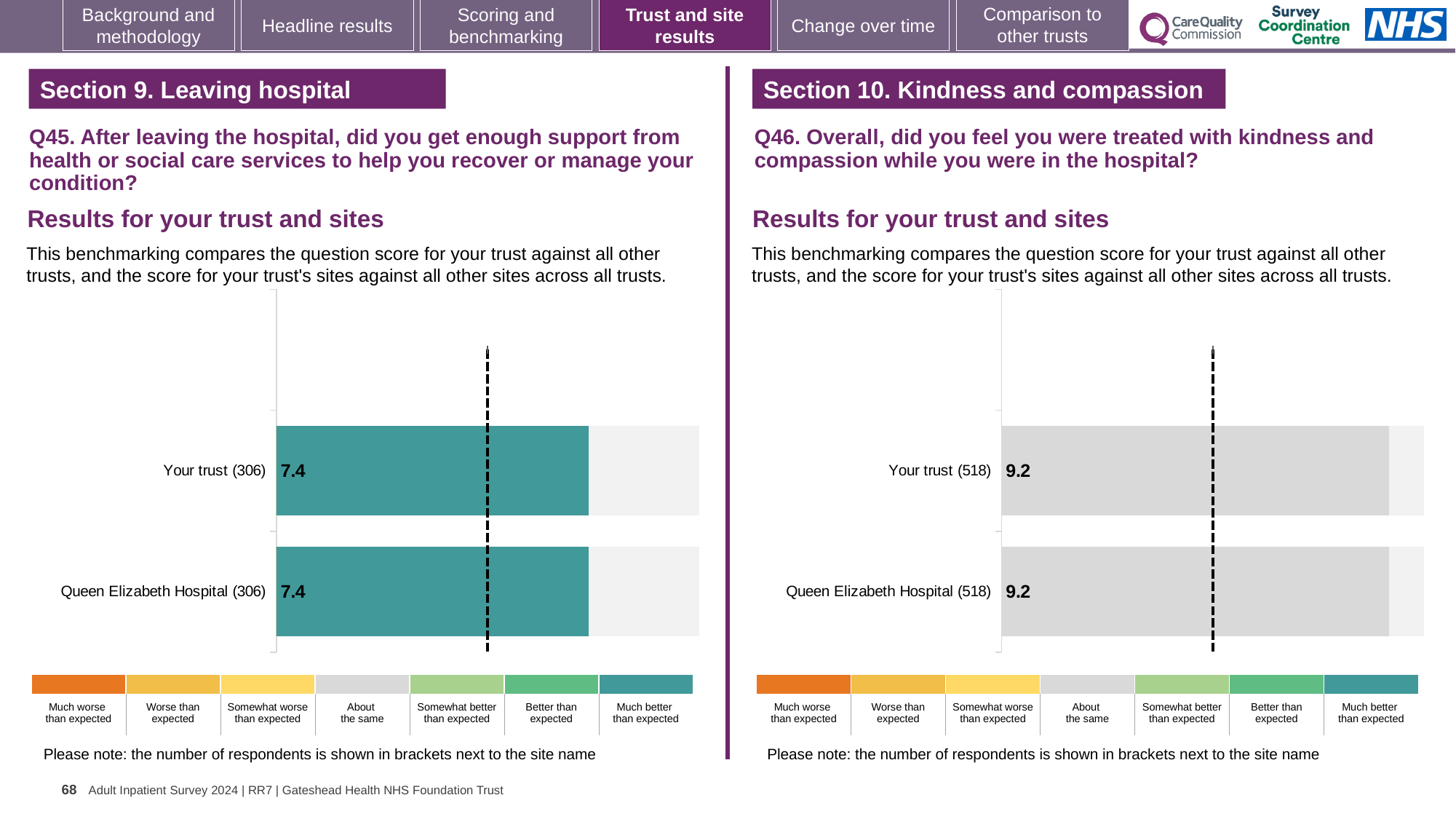
According to the colour key, which benchmark category do the bars on the Q46 chart (right) fall into? About the same On the Q46 chart (right), what is the difference between the score for Your trust and the score for Queen Elizabeth Hospital? 0.0 On the Q45 chart (left), what is the difference between the score for Your trust and the score for Queen Elizabeth Hospital? 0.0 On the Q45 chart (left), what is the score for Your trust? 7.4 On the Q46 chart (right), what is the score for Your trust? 9.2 On the Q46 chart (right), what is the score for Queen Elizabeth Hospital? 9.2 On the Q46 chart (right), how many respondents are shown in brackets for Queen Elizabeth Hospital? 518 What kind of chart is the Q45 chart (left)? Bar chart How many bars are plotted on the Q45 chart (left)? 2 On the Q45 chart (left), what is the score for Queen Elizabeth Hospital? 7.4 On the Q45 chart (left), how many respondents are shown in brackets for Your trust? 306 How many bars are plotted on the Q46 chart (right)? 2